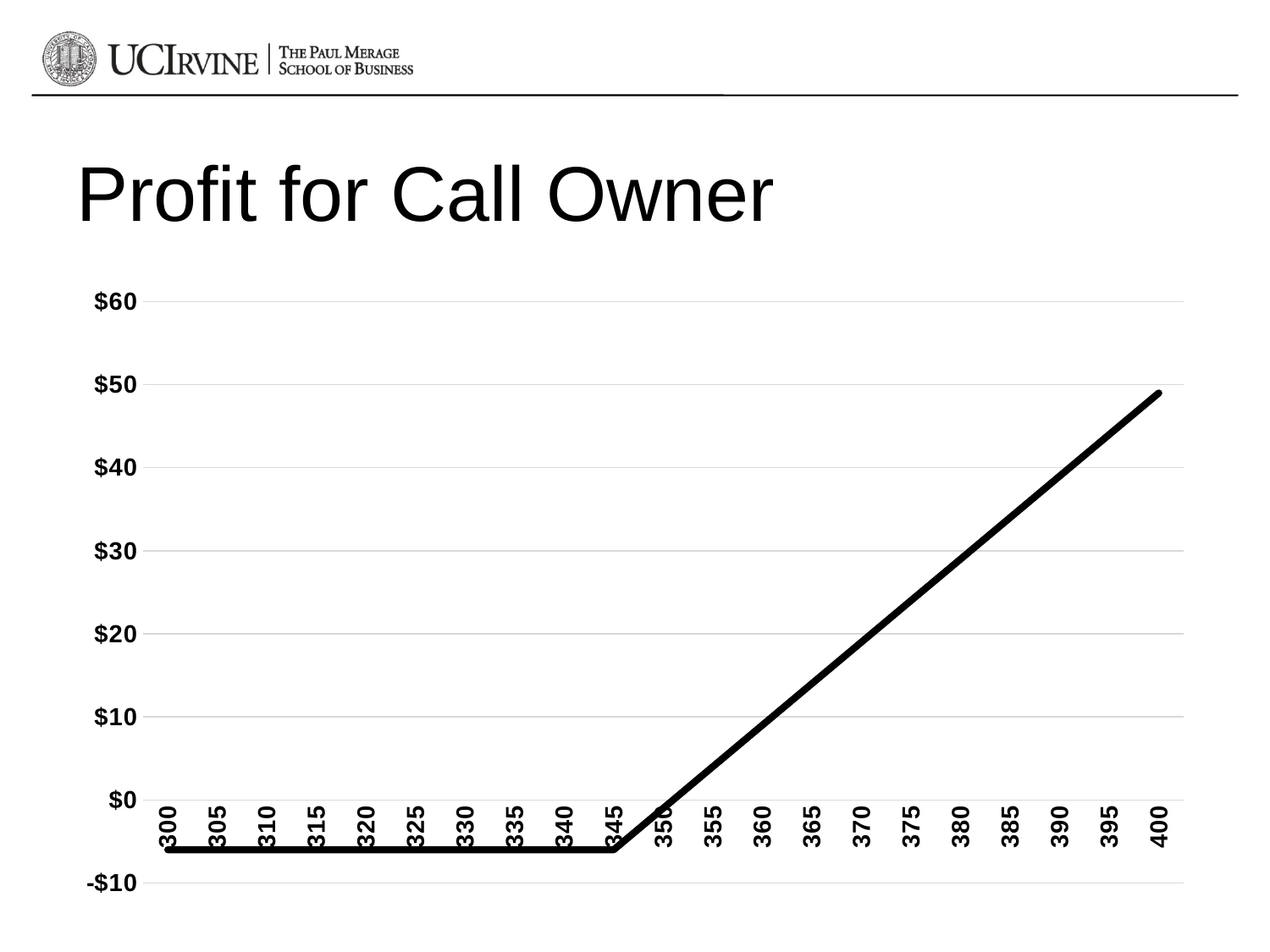
Is the profit at 360 greater or less than $0? greater At which x-axis value is the profit highest? 400 What kind of chart is shown on the slide? line chart Is the profit at 380 greater or less than $20? greater How many points are labelled along the x axis of the chart? 21 Is the profit at 385 greater or less than $40? less What is the title of the chart? Profit for Call Owner Which has the larger profit, 300 or 400? 400 What is the highest value shown on the y axis? $60 Does the profit rise or fall as the x-axis value increases from 345 to 400? rise